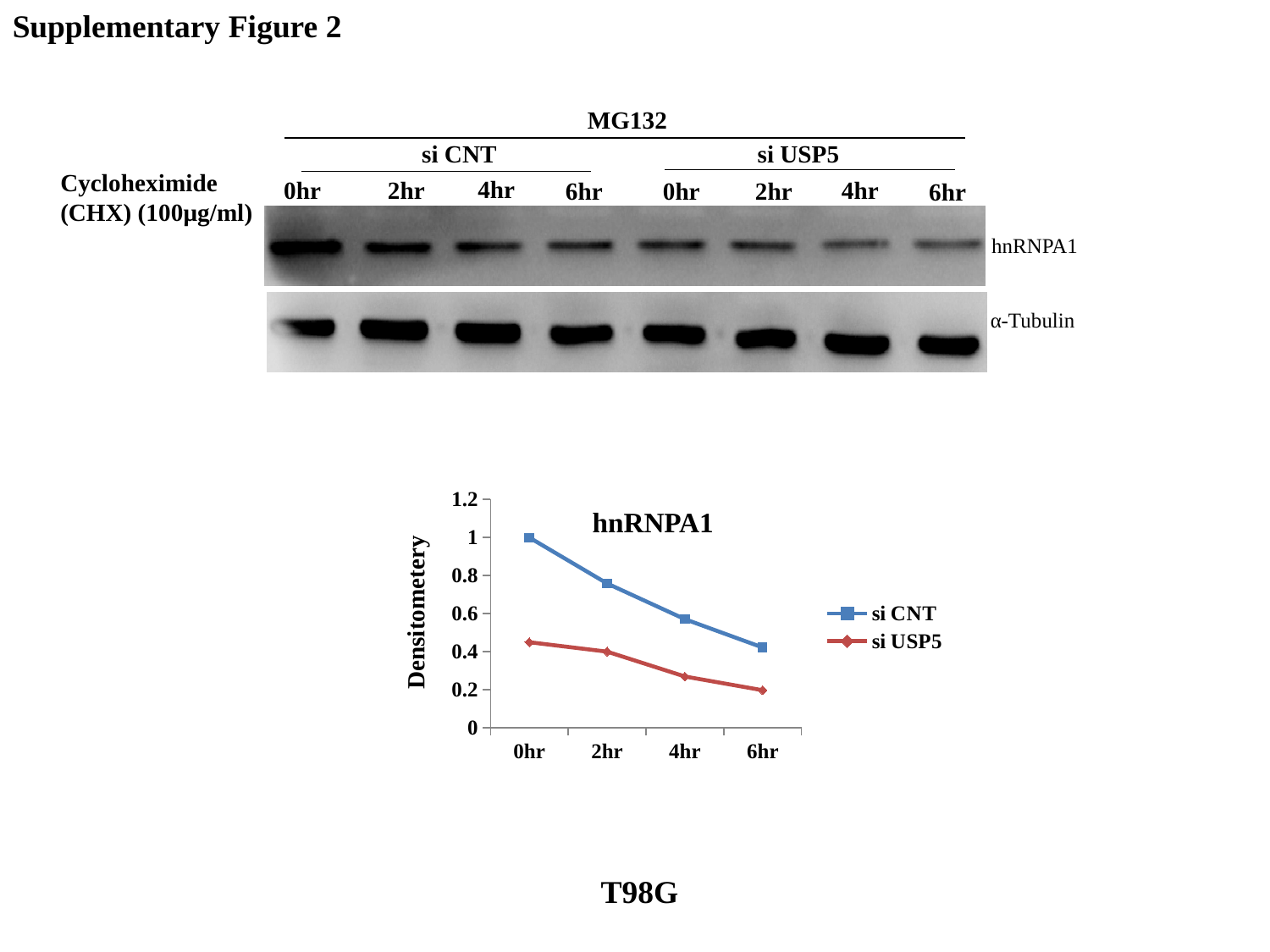
Do the si CNT values rise or fall from 0hr to 6hr in the hnRNPA1 chart? fall Is the si CNT value at 2hr greater or less than 0.6 in the hnRNPA1 chart? greater At 4hr, which series has the larger value in the hnRNPA1 chart, si CNT or si USP5? si CNT Is the si USP5 value at 0hr greater or less than 0.6 in the hnRNPA1 chart? less At which time point is the si USP5 value lowest in the hnRNPA1 chart? 6hr What is the label of the y axis of the hnRNPA1 chart? Densitometery Do the si USP5 values rise or fall from 0hr to 6hr in the hnRNPA1 chart? fall What is the densitometry value for si CNT at 0hr in the hnRNPA1 chart? 1 How many time points are plotted along the x axis of the hnRNPA1 chart? 4 At which time point is the si CNT value highest in the hnRNPA1 chart? 0hr How many series does the legend of the hnRNPA1 chart list? 2 What kind of chart is shown on the slide? line chart